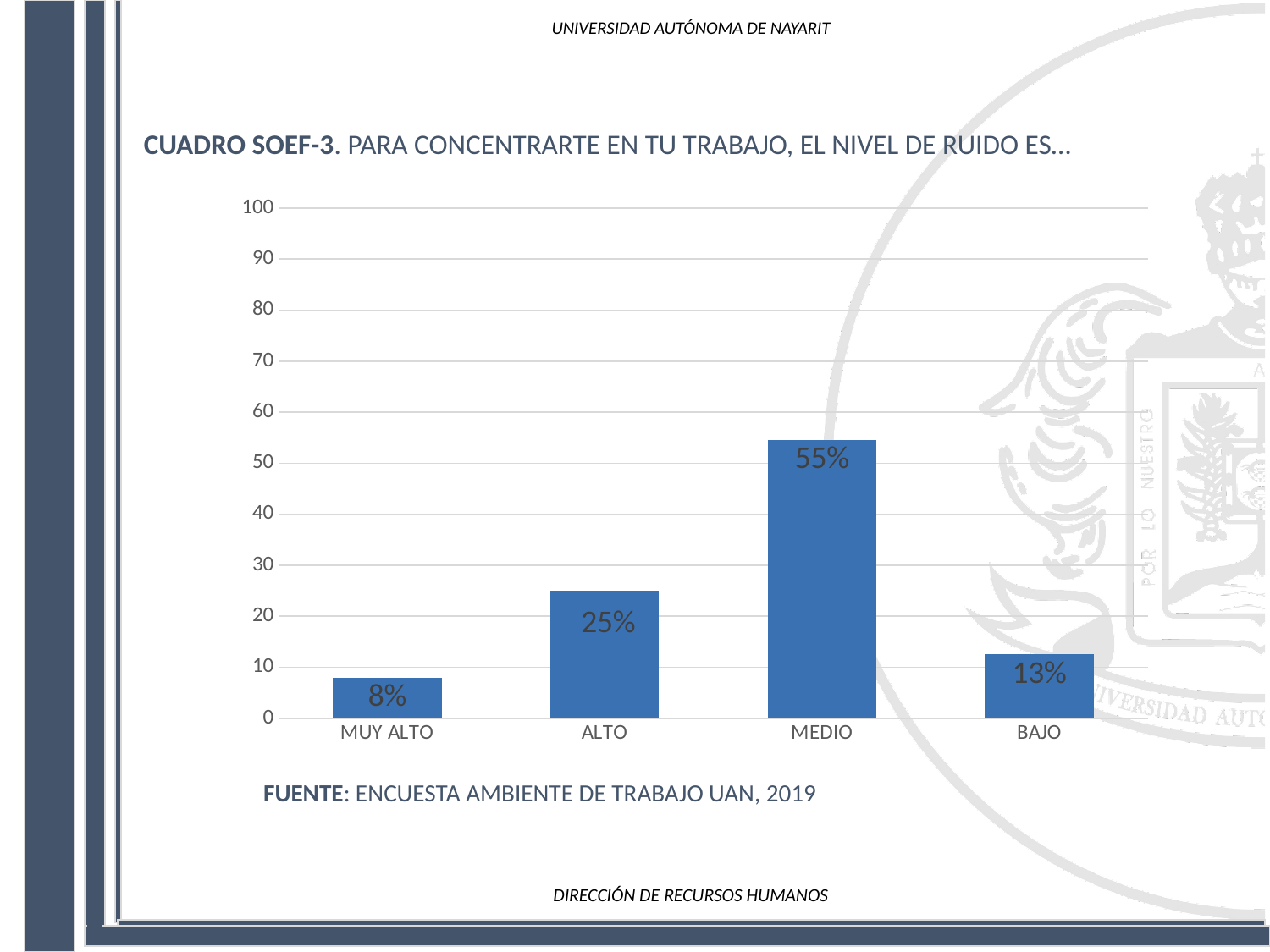
Which category has the lowest value? MUY ALTO What is the difference between the values for MEDIO and ALTO? 30% What is the value for BAJO? 13% What kind of chart is shown on the slide? bar chart Which is larger, the value for ALTO or the value for BAJO? ALTO Which category has the highest value? MEDIO What source is cited below the chart? ENCUESTA AMBIENTE DE TRABAJO UAN, 2019 What is the value for MUY ALTO? 8% Is the value for MEDIO greater or less than 50? greater How many categories are shown on the x axis? 4 What is the difference between the values for BAJO and MUY ALTO? 5% What is the value for MEDIO? 55%